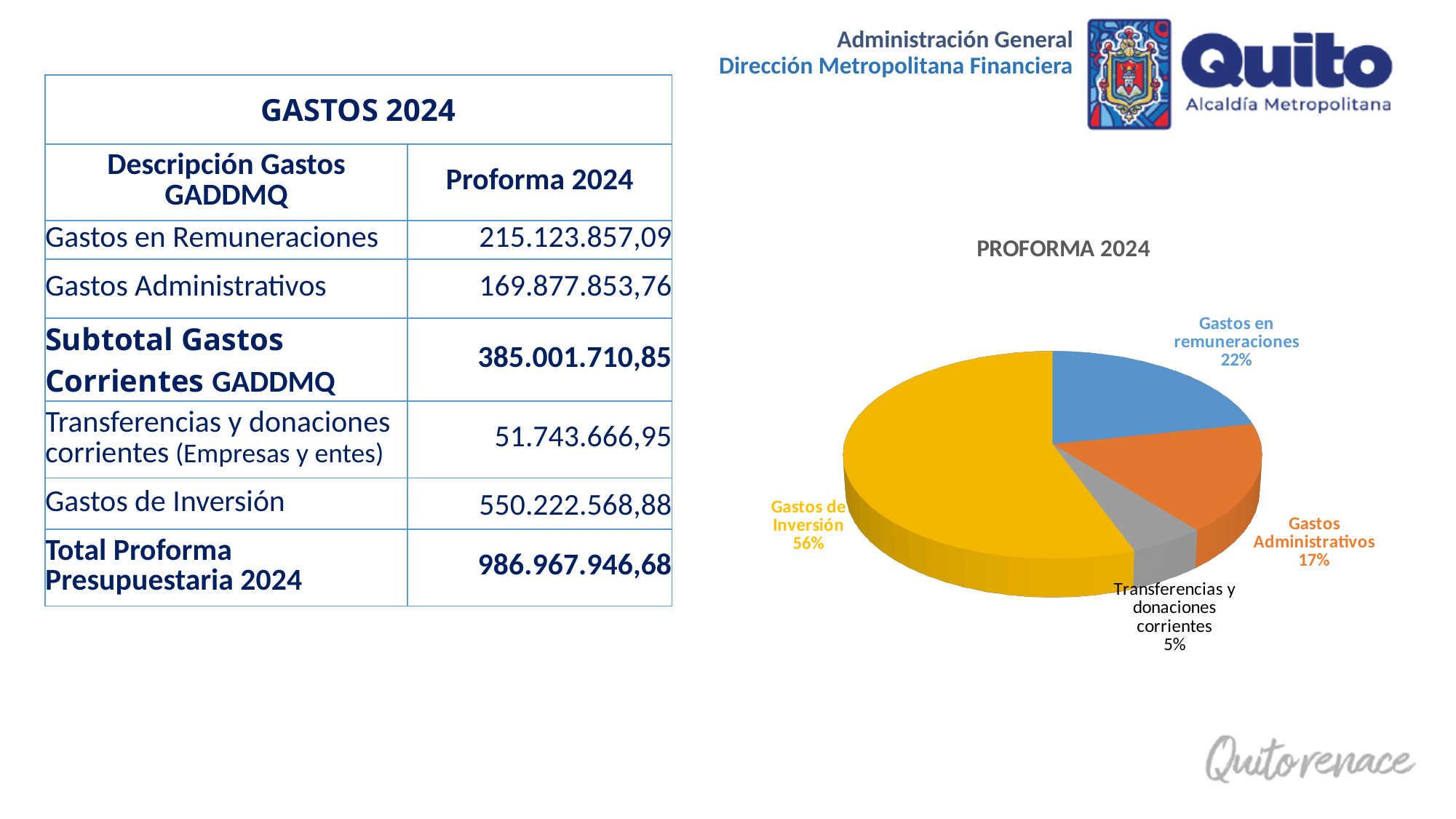
Which slice of the pie chart is the largest? Gastos de Inversión What is the title of the chart? PROFORMA 2024 How many slices does the pie chart have? 4 What share of the pie does Transferencias y donaciones corrientes represent? 5% Which slice of the pie chart is the smallest? Transferencias y donaciones corrientes What colour is the Gastos de Inversión slice in the pie chart? yellow What share of the pie does Gastos en remuneraciones represent? 22% What share of the pie does Gastos Administrativos represent? 17% What kind of chart is shown on the slide? pie chart What is the difference in percentage points between Gastos de Inversión and Gastos en remuneraciones? 34 Which is larger in the pie chart, Gastos en remuneraciones or Gastos Administrativos? Gastos en remuneraciones